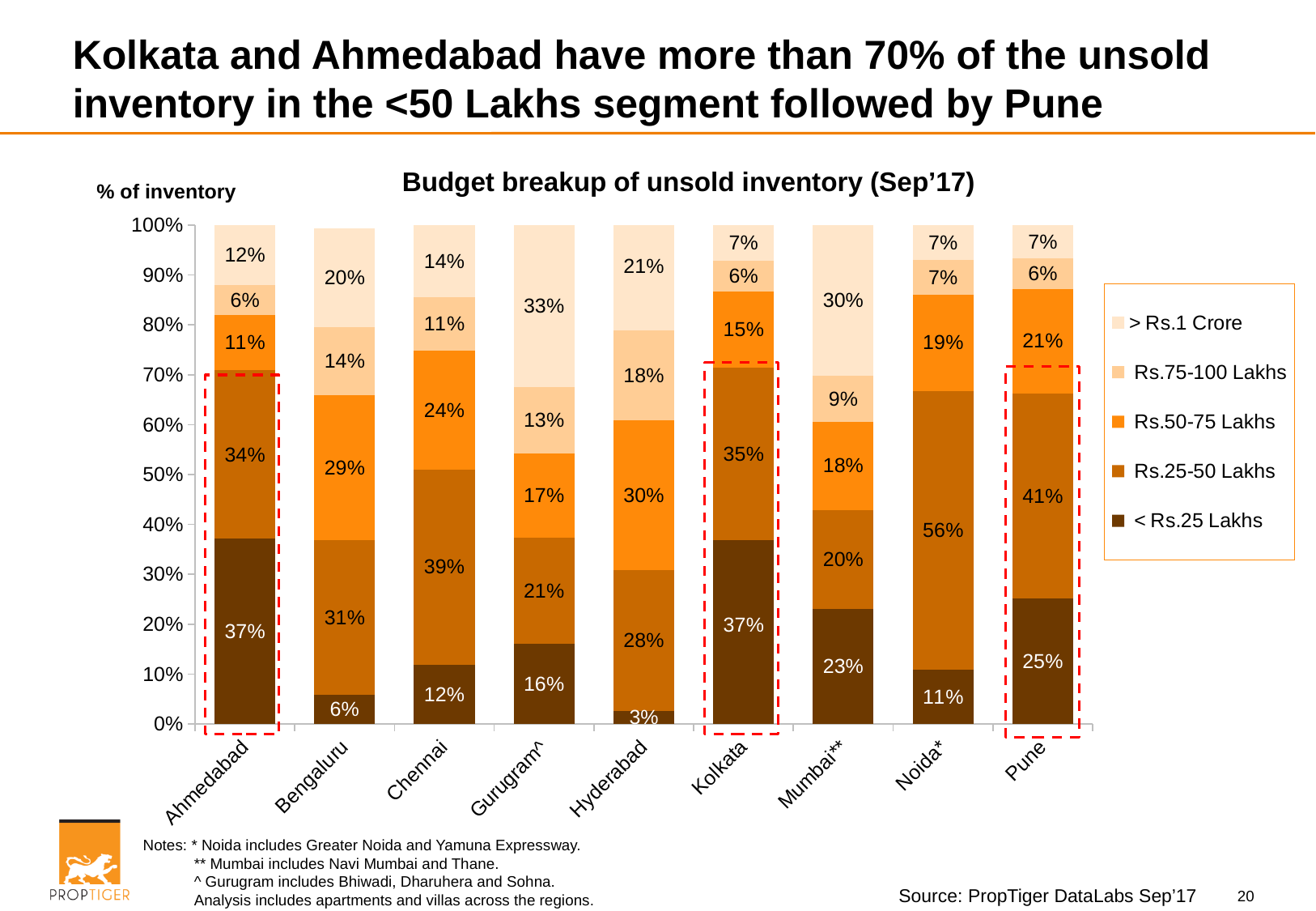
What is the difference between the > Rs.1 Crore share for Mumbai** and for Kolkata? 23% What is the title of the chart? Budget breakup of unsold inventory (Sep'17) How many series does the legend list? 5 What is the Rs.25-50 Lakhs share of unsold inventory for Noida*? 56% What is the combined share of the < Rs.25 Lakhs and Rs.25-50 Lakhs segments for Ahmedabad? 71% How many cities are shown on the x axis of the chart? 9 Which city has the lowest < Rs.25 Lakhs share? Hyderabad What kind of chart is shown on the slide? stacked bar chart Which is larger: the Rs.50-75 Lakhs share for Hyderabad or for Chennai? Hyderabad What is the > Rs.1 Crore share of unsold inventory for Gurugram^? 33% Which city has the highest Rs.25-50 Lakhs share? Noida* What is the < Rs.25 Lakhs share of unsold inventory for Kolkata? 37%